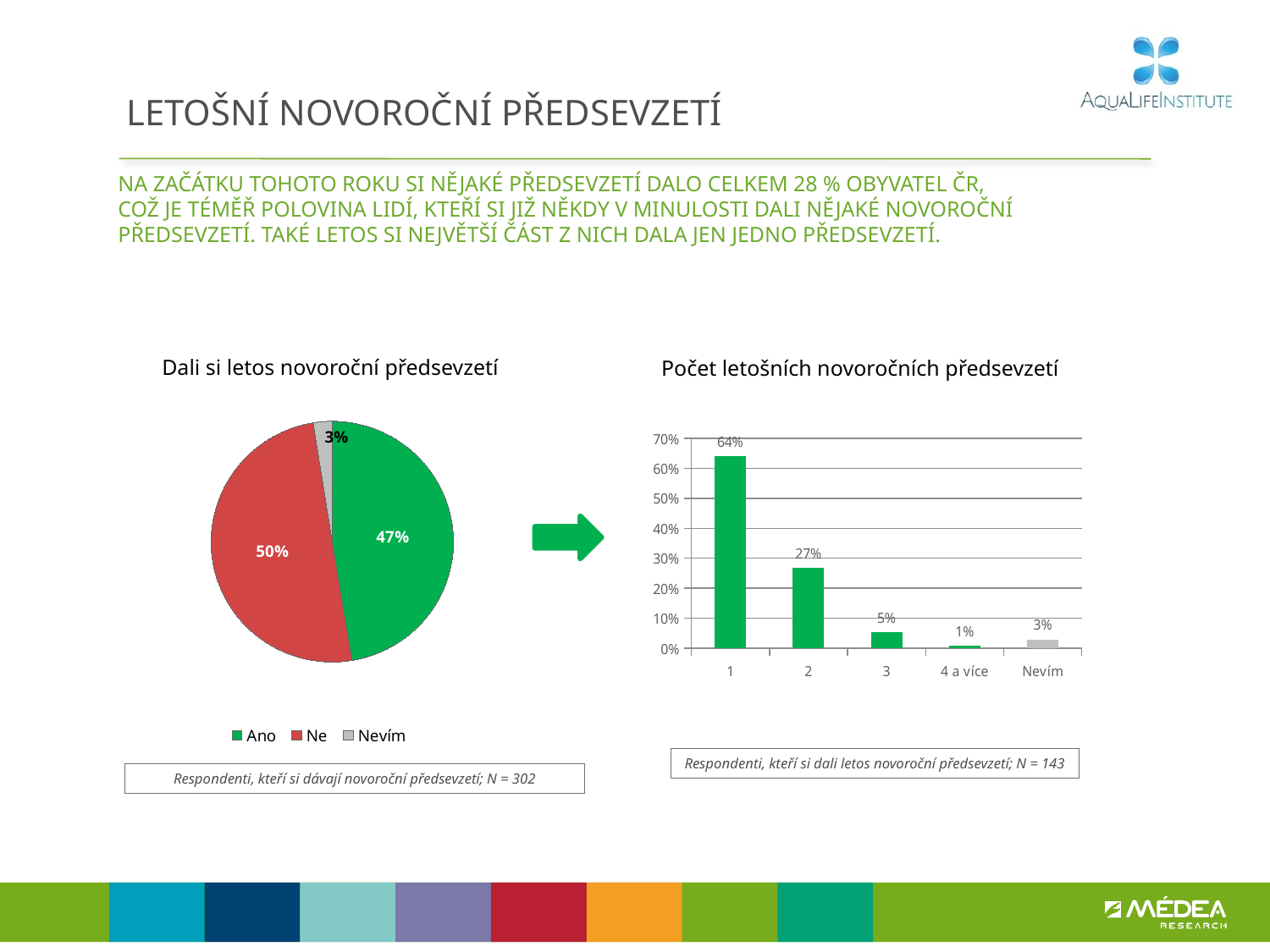
In the chart 'Počet letošních novoročních předsevzetí', what is the value for category '1'? 64% In the pie chart 'Dali si letos novoroční předsevzetí', which category has the smallest slice? Nevím In the pie chart 'Dali si letos novoroční předsevzetí', how many entries does the legend list? 3 In the chart 'Počet letošních novoročních předsevzetí', what is the difference between the values for '1' and '2'? 37% In the chart 'Počet letošních novoročních předsevzetí', which is larger, the value for '3' or the value for 'Nevím'? 3 In the chart 'Počet letošních novoročních předsevzetí', how many categories are shown on the x axis? 5 In the chart 'Počet letošních novoročních předsevzetí', which category has the highest value? 1 In the chart 'Počet letošních novoročních předsevzetí', what is the value for category '4 a více'? 1% In the pie chart 'Dali si letos novoroční předsevzetí', what share is labelled for 'Ano'? 47% In the pie chart 'Dali si letos novoroční předsevzetí', what colour is the 'Ne' slice? Red What kind of chart is 'Počet letošních novoročních předsevzetí'? Bar chart In the pie chart 'Dali si letos novoroční předsevzetí', what share is labelled for 'Ne'? 50%